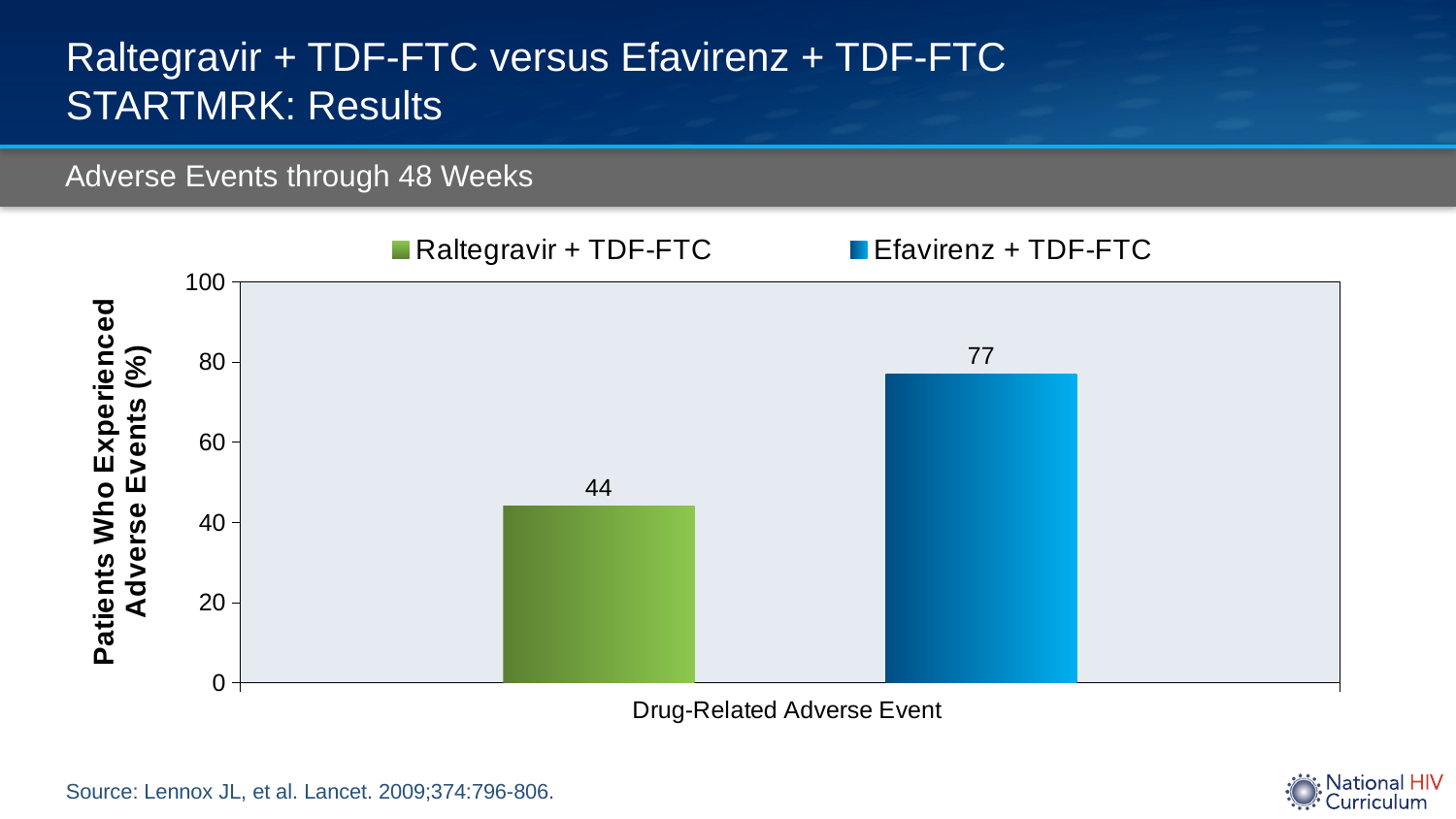
What percentage of patients in the Efavirenz + TDF-FTC group experienced a drug-related adverse event? 77 How many series does the legend list? 2 What colour is the bar for Efavirenz + TDF-FTC? Blue Which treatment group had the lower percentage of patients with a drug-related adverse event? Raltegravir + TDF-FTC Is the value for Raltegravir + TDF-FTC greater or less than 60? less Which treatment group had the higher percentage of patients with a drug-related adverse event? Efavirenz + TDF-FTC What kind of chart is shown on the slide? Bar chart Is the value for Efavirenz + TDF-FTC greater or less than 60? greater What percentage of patients in the Raltegravir + TDF-FTC group experienced a drug-related adverse event? 44 What is the difference in percentage points between the Efavirenz + TDF-FTC and Raltegravir + TDF-FTC groups for drug-related adverse events? 33 What is the label on the y-axis of the chart? Patients Who Experienced Adverse Events (%) Is the value for Raltegravir + TDF-FTC larger or smaller than the value for Efavirenz + TDF-FTC? smaller